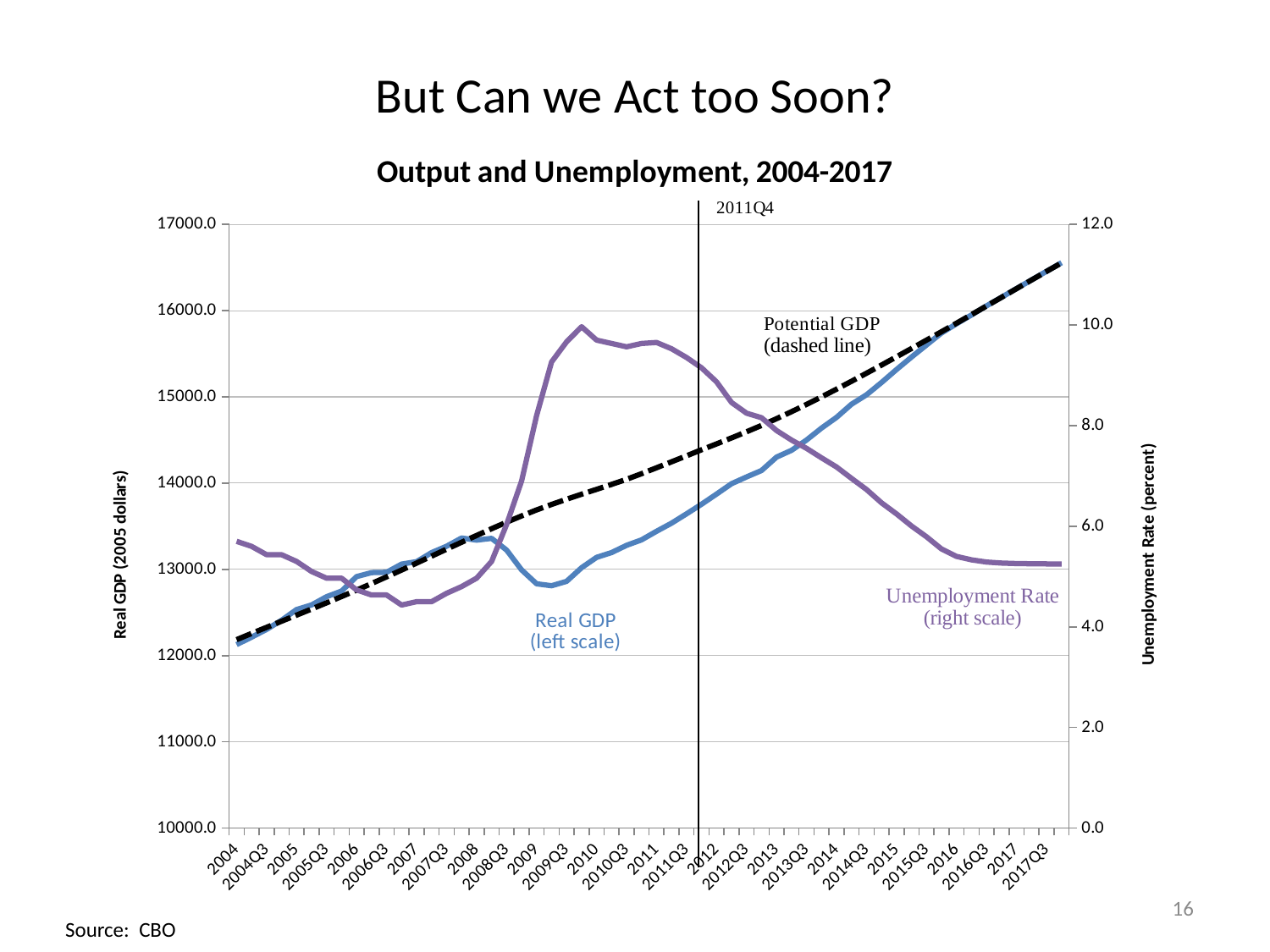
Does the Potential GDP (dashed line) rise or fall from 2004 to 2017Q3? rise Is Real GDP at 2009 greater or less than 13000.0? less Is Real GDP at 2017Q3 greater or less than 16000.0? greater What kind of chart is shown on the slide? line chart Which quarter is marked by the vertical line on the chart? 2011Q4 How many data series are plotted on the chart? 3 Is the Unemployment Rate at 2017Q3 greater or less than 6.0? less Which is higher, Real GDP at 2008 or Real GDP at 2009? 2008 What is the title of the chart? Output and Unemployment, 2004-2017